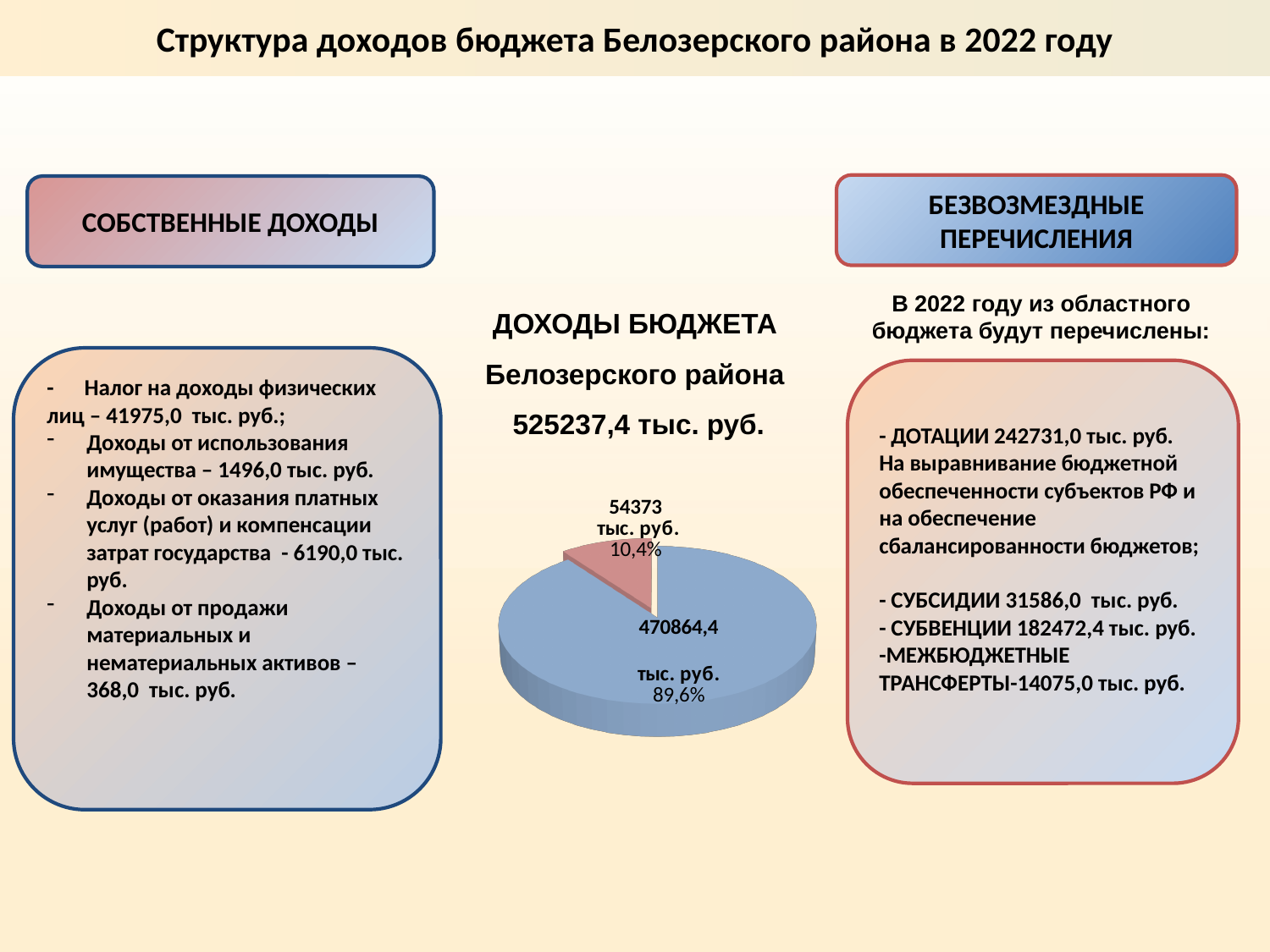
What percentage share is shown for the blue slice of the pie chart? 89,6% What colour is the slice representing 89,6% of the pie chart? blue What kind of chart is shown in the centre of the slide? pie chart Which slice of the pie chart is larger, the pink one or the blue one? the blue one How many slices does the pie chart have? 2 What value in тыс. руб. is labelled on the pink slice of the pie chart? 54373 тыс. руб. What percentage share is shown for the pink slice of the pie chart? 10,4% What total budget revenue figure is stated above the pie chart? 525237,4 тыс. руб. Which slice of the pie chart has the smallest share? the pink slice (10,4%) What is the difference between the two values shown on the pie chart, 470864,4 and 54373 тыс. руб.? 416491,4 тыс. руб. What value in тыс. руб. is labelled on the blue slice of the pie chart? 470864,4 тыс. руб. What is the difference in percentage points between the blue slice (89,6%) and the pink slice (10,4%) of the pie chart? 79,2 percentage points